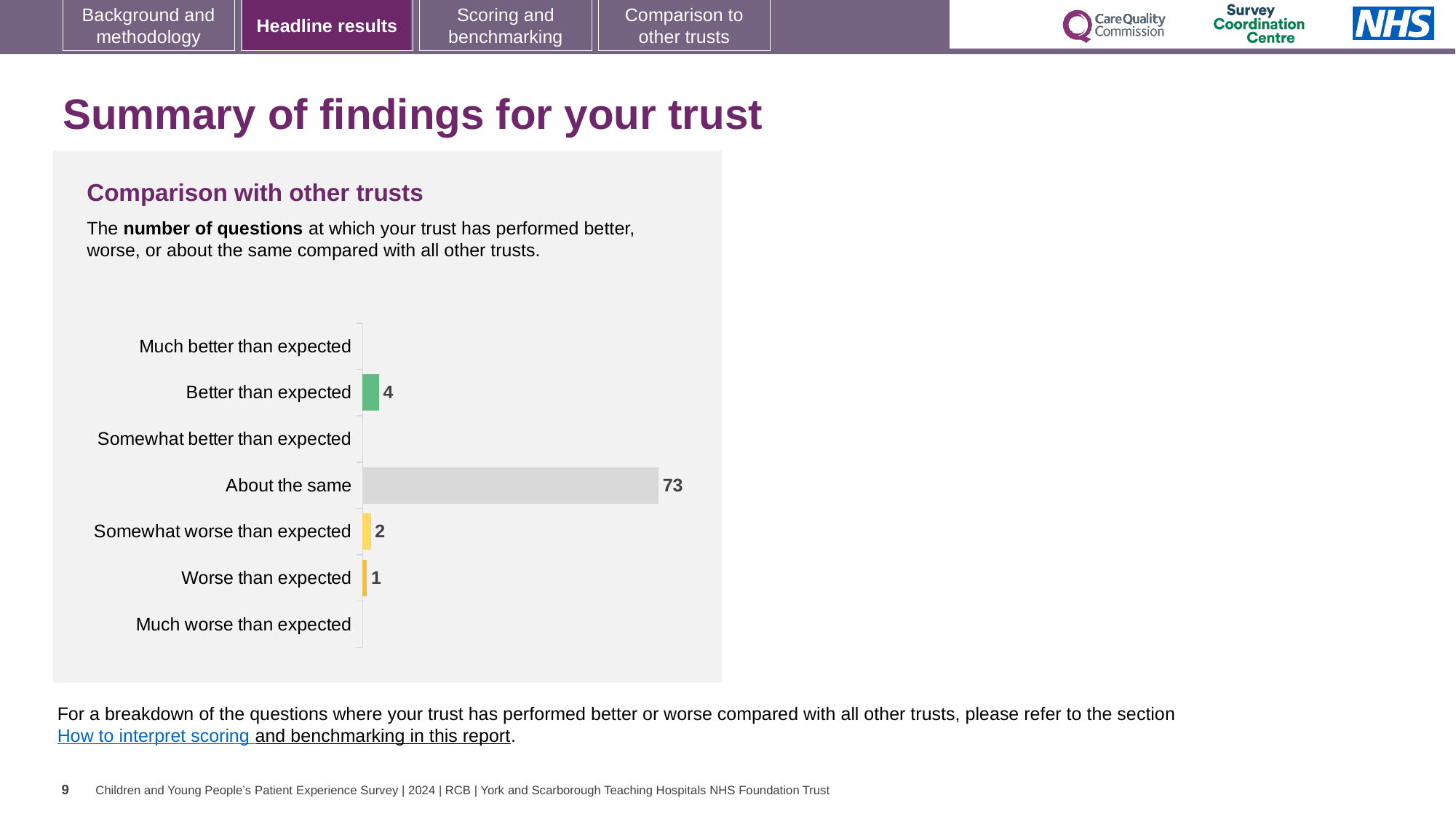
Which category has the highest value? About the same What is the value for 'Better than expected'? 4 What is the difference between the values for 'Better than expected' and 'Somewhat worse than expected'? 2 Which is larger, the value for 'Better than expected' or the value for 'Worse than expected'? Better than expected What is the value for 'Worse than expected'? 1 What colour is the bar for 'Better than expected'? Green What kind of chart is shown on the slide? Bar chart What is the value for 'Somewhat worse than expected'? 2 What is the value for 'About the same'? 73 How many categories are listed on the chart's axis? 7 What is the title of the chart section? Comparison with other trusts What is the difference between the values for 'About the same' and 'Better than expected'? 69